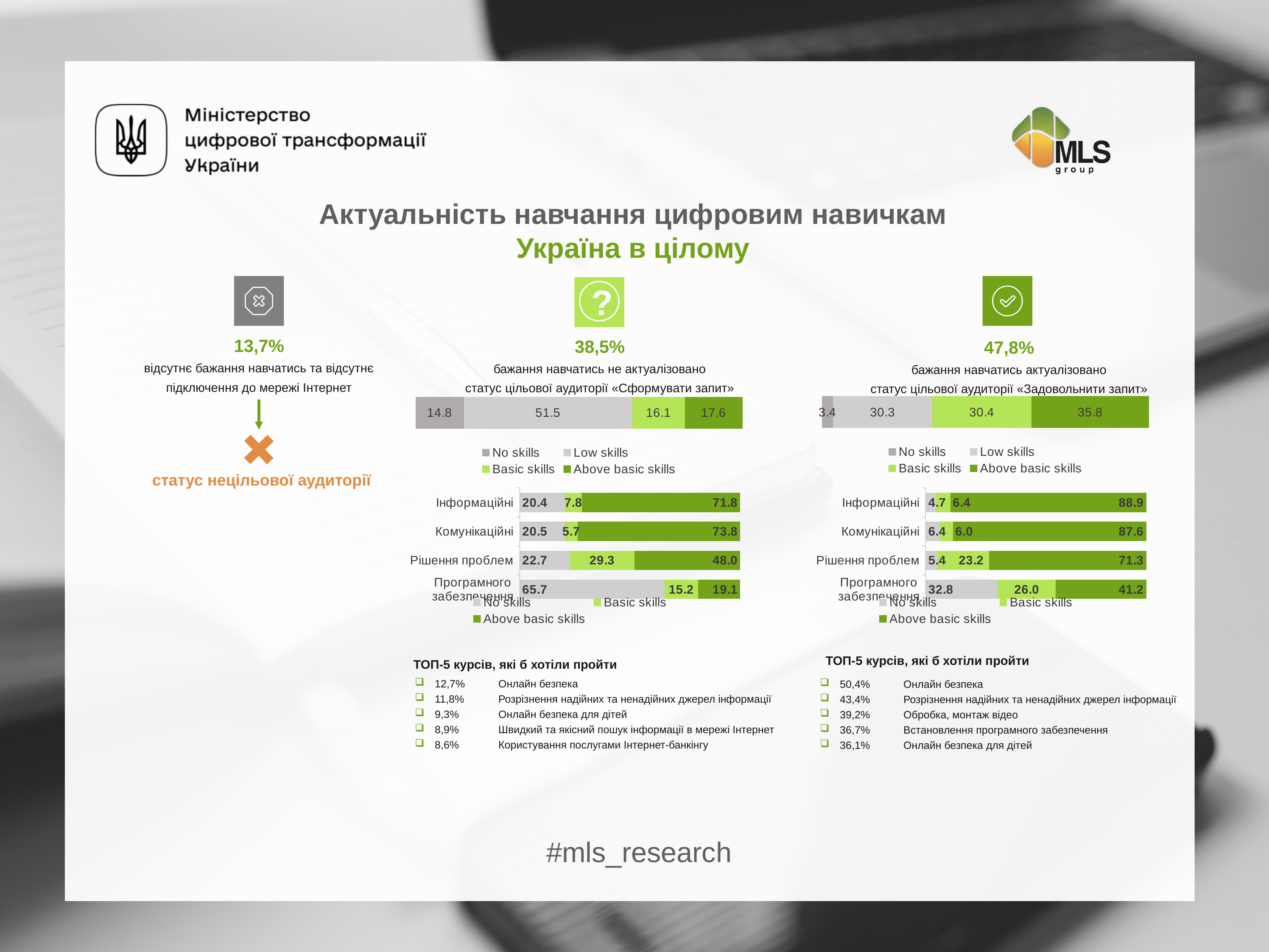
In the middle four-category stacked bar chart (under the 38,5% block), what is the difference between the Basic skills values for Рішення проблем and Інформаційні? 21.5 In the middle four-category stacked bar chart (under the 38,5% block), what is the Above basic skills value for Комунікаційні? 73.8 In the single stacked bar under 38,5% in the middle of the slide, what is the value for Low skills? 51.5 In the single stacked bar under 47,8% on the right of the slide, what is the value for Above basic skills? 35.8 In the right four-category stacked bar chart (under the 47,8% block), which is larger: the Basic skills value for Рішення проблем or for Комунікаційні? Рішення проблем What type of chart is the middle four-category chart under the 38,5% block? Stacked bar chart In the right four-category stacked bar chart (under the 47,8% block), what is the Above basic skills value for Інформаційні? 88.9 How many categories are shown in the right four-category stacked bar chart (under the 47,8% block)? 4 In the right four-category stacked bar chart (under the 47,8% block), which category has the lowest Above basic skills value? Програмного забезпечення In the middle four-category stacked bar chart (under the 38,5% block), which category has the highest No skills value? Програмного забезпечення In the single stacked bar under 47,8% on the right of the slide, which segment is the smallest? No skills In the single stacked bar under 38,5% in the middle of the slide, how many series does the legend list? 4